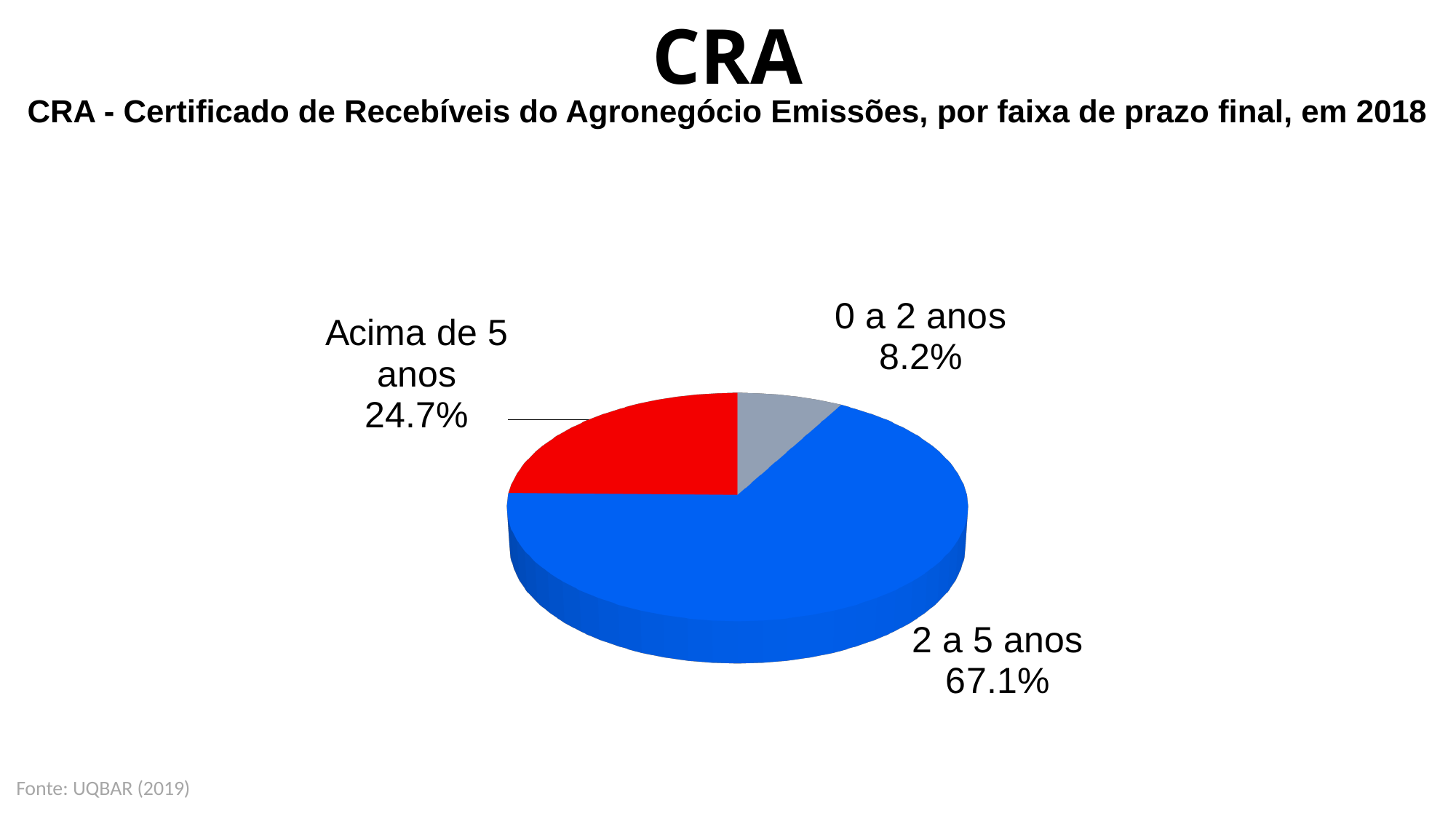
Which slice is larger, "Acima de 5 anos" or "0 a 2 anos"? Acima de 5 anos What kind of chart is shown on the slide? pie chart Which category has the largest slice of the pie? 2 a 5 anos What is the difference in percentage points between the "2 a 5 anos" and "Acima de 5 anos" slices? 42.4 What is the difference in percentage points between the "Acima de 5 anos" and "0 a 2 anos" slices? 16.5 What share of the pie does the "Acima de 5 anos" slice represent? 24.7% Which category has the smallest slice of the pie? 0 a 2 anos What colour is the "2 a 5 anos" slice? blue What share of the pie does the "0 a 2 anos" slice represent? 8.2% What share of the pie does the "2 a 5 anos" slice represent? 67.1% How many slices does the pie chart have? 3 What is the source cited at the bottom of the slide? UQBAR (2019)